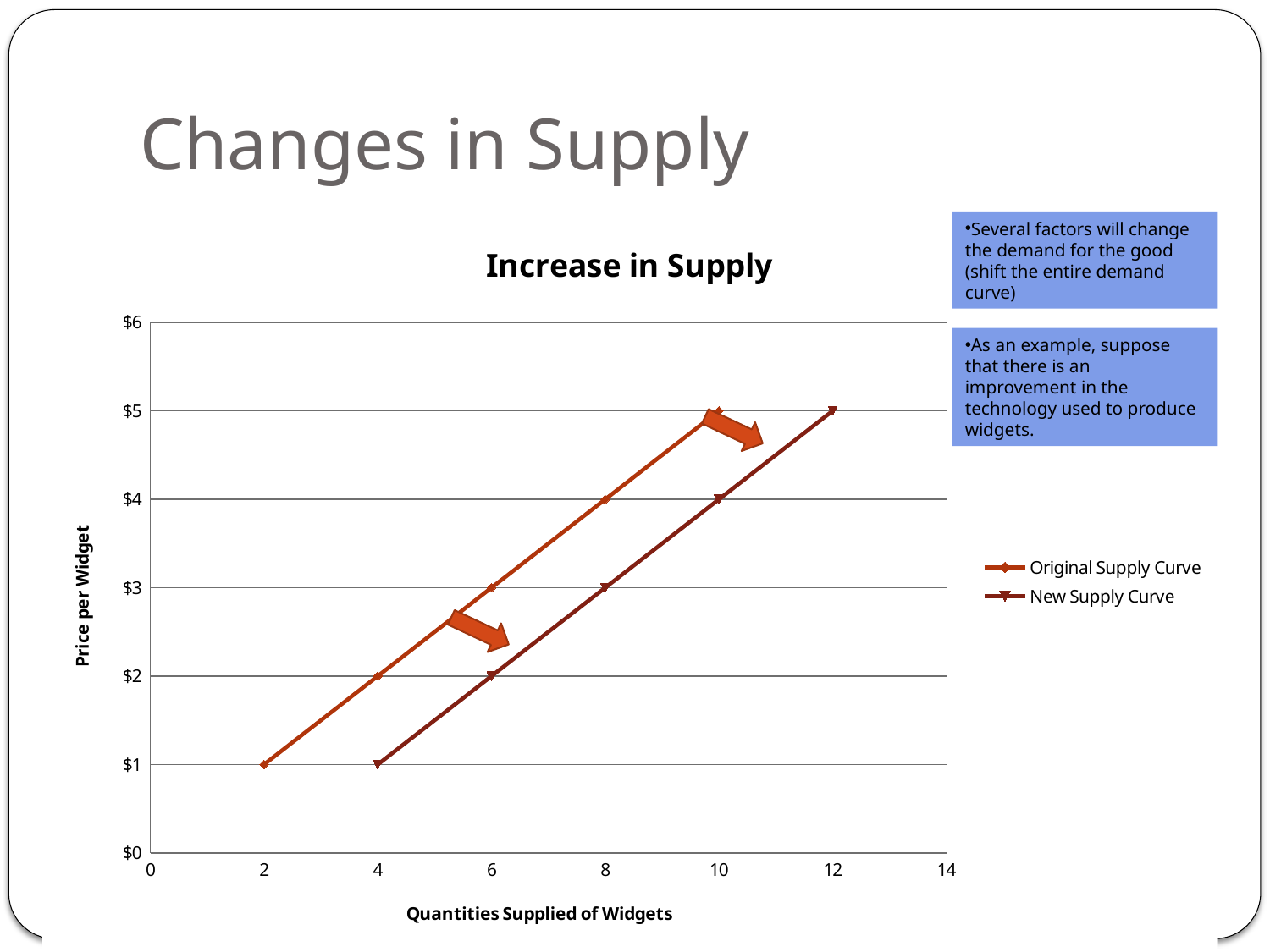
At a price of $3, what quantity is supplied on the New Supply Curve? 8 At a price of $4, which curve shows the larger quantity supplied, the Original Supply Curve or the New Supply Curve? New Supply Curve At a price of $5, how much larger is the quantity supplied on the New Supply Curve than on the Original Supply Curve? 2 Does the price per widget rise or fall as the quantity supplied increases along the Original Supply Curve? Rise What is the price per widget on the New Supply Curve when the quantity supplied is 12? $5 How many series does the chart's legend list? 2 What is the title of the chart? Increase in Supply What kind of chart is shown on the slide? Line chart What is the price per widget on the Original Supply Curve when the quantity supplied is 2? $1 What is the label of the x axis? Quantities Supplied of Widgets At a price of $3, what quantity is supplied on the Original Supply Curve? 6 How many data points are plotted on the Original Supply Curve? 5